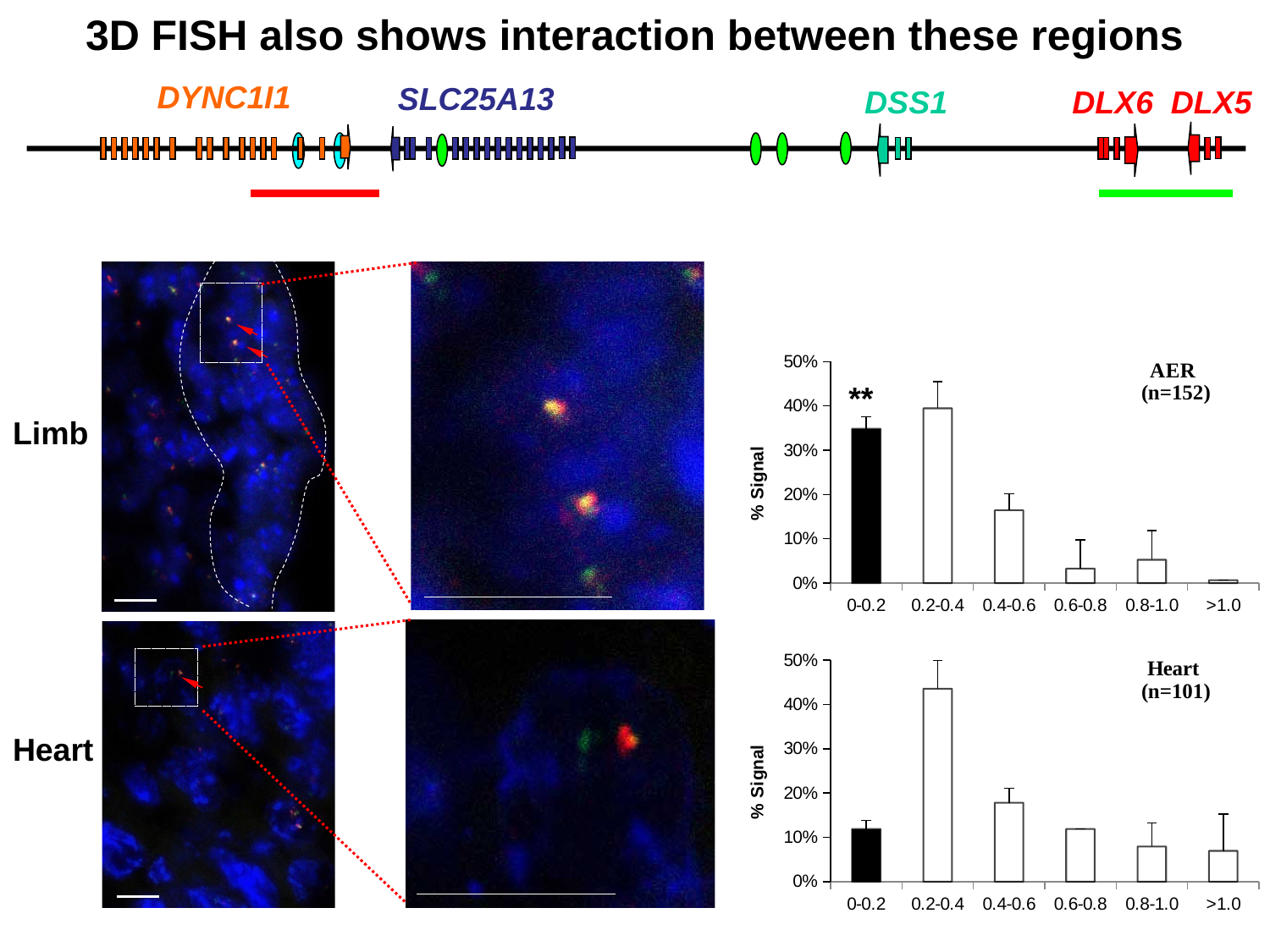
In the AER (n=152) chart, is the value for 0.4-0.6 greater or less than 20%? less What kind of chart is the AER (n=152) chart? bar chart In the Heart (n=101) chart, is the value for 0.2-0.4 greater or less than 40%? greater In the AER (n=152) chart, which category has the highest % Signal? 0.2-0.4 In the AER (n=152) chart, which is larger, the value for 0.4-0.6 or the value for 0.6-0.8? 0.4-0.6 In the AER (n=152) chart, is the value for 0-0.2 greater or less than 30%? greater In the Heart (n=101) chart, which is larger, the value for 0.4-0.6 or the value for 0.8-1.0? 0.4-0.6 In the AER (n=152) chart, which category has the lowest % Signal? >1.0 How many categories are shown on the x axis of the Heart (n=101) chart? 6 In the Heart (n=101) chart, which category has the highest % Signal? 0.2-0.4 What is the y-axis label of the Heart (n=101) chart? % Signal